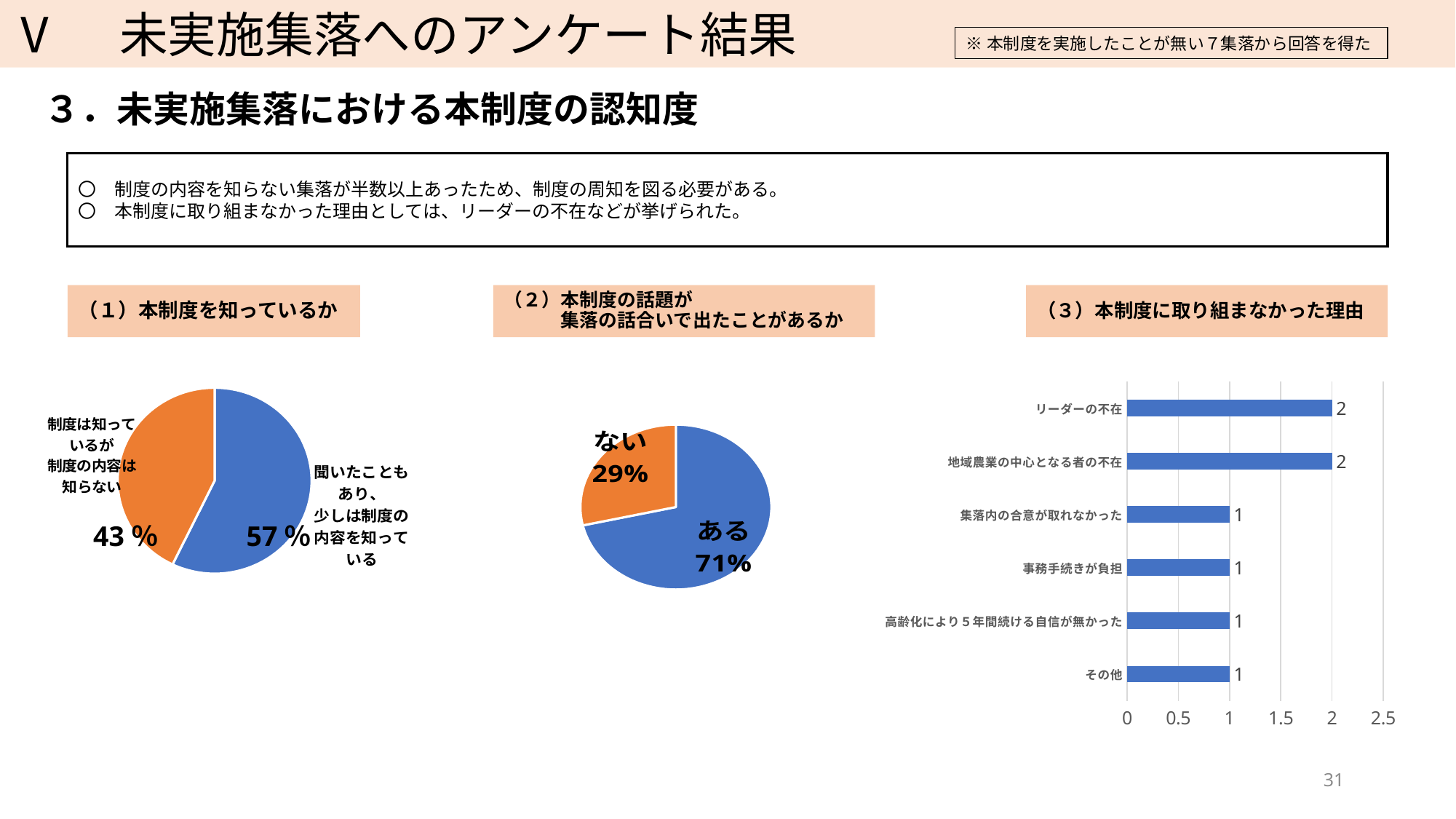
In the chart titled （２）本制度の話題が集落の話合いで出たことがあるか, what is the difference in percentage points between ある and ない? 42 In the chart titled （２）本制度の話題が集落の話合いで出たことがあるか, what percentage is labelled ある? 71% In the chart titled （３）本制度に取り組まなかった理由, what is the difference between the values for 地域農業の中心となる者の不在 and その他? 1 In the chart titled （３）本制度に取り組まなかった理由, how many categories are shown? 6 In the chart titled （３）本制度に取り組まなかった理由, what is the value for 事務手続きが負担? 1 In the chart titled （３）本制度に取り組まなかった理由, what is the value for リーダーの不在? 2 What kind of chart is used for （３）本制度に取り組まなかった理由? Bar chart In the chart titled （１）本制度を知っているか, which slice is larger: 制度は知っているが制度の内容は知らない or 聞いたこともあり、少しは制度の内容を知っている? 聞いたこともあり、少しは制度の内容を知っている What kind of chart is used for （１）本制度を知っているか? Pie chart In the chart titled （１）本制度を知っているか, what share of the pie is labelled 制度は知っているが制度の内容は知らない? 43％ In the chart titled （１）本制度を知っているか, what share of the pie is labelled 聞いたこともあり、少しは制度の内容を知っている? 57％